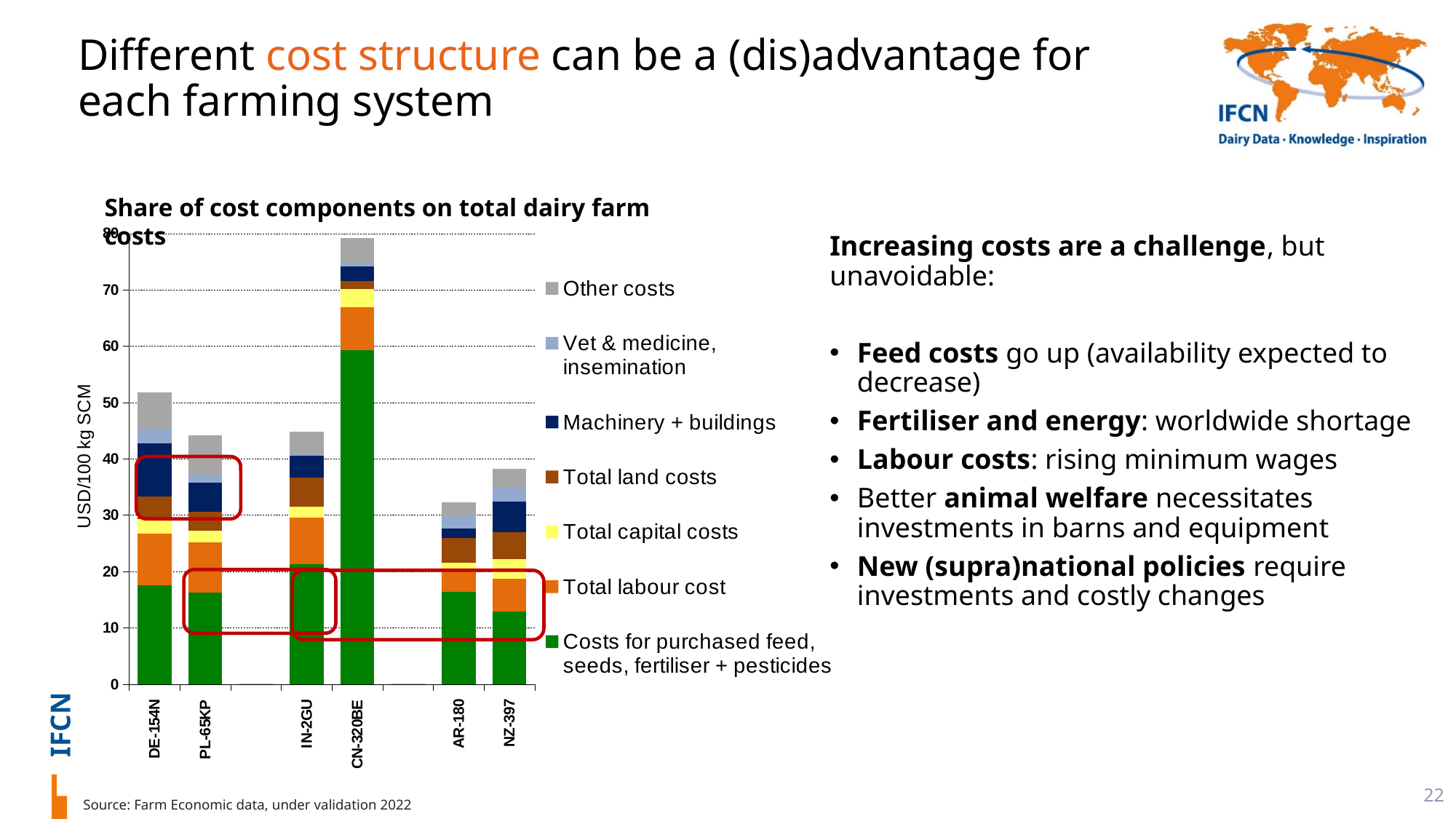
Which farm has the lowest total cost bar? AR-180 Which farm has the highest total cost bar? CN-320BE Is the total cost bar for CN-320BE greater or less than 70? greater Which has the larger total cost bar, DE-154N or PL-65KP? DE-154N Is the 'Costs for purchased feed, seeds, fertiliser + pesticides' segment for CN-320BE greater or less than 50? greater Is the total cost bar for AR-180 greater or less than 40? less What kind of chart is shown on the slide? stacked bar chart How many farm categories are shown on the x axis of the chart? 6 What is the label of the chart's vertical axis? USD/100 kg SCM How many series does the chart legend list? 7 Which has the larger total cost bar, AR-180 or NZ-397? NZ-397